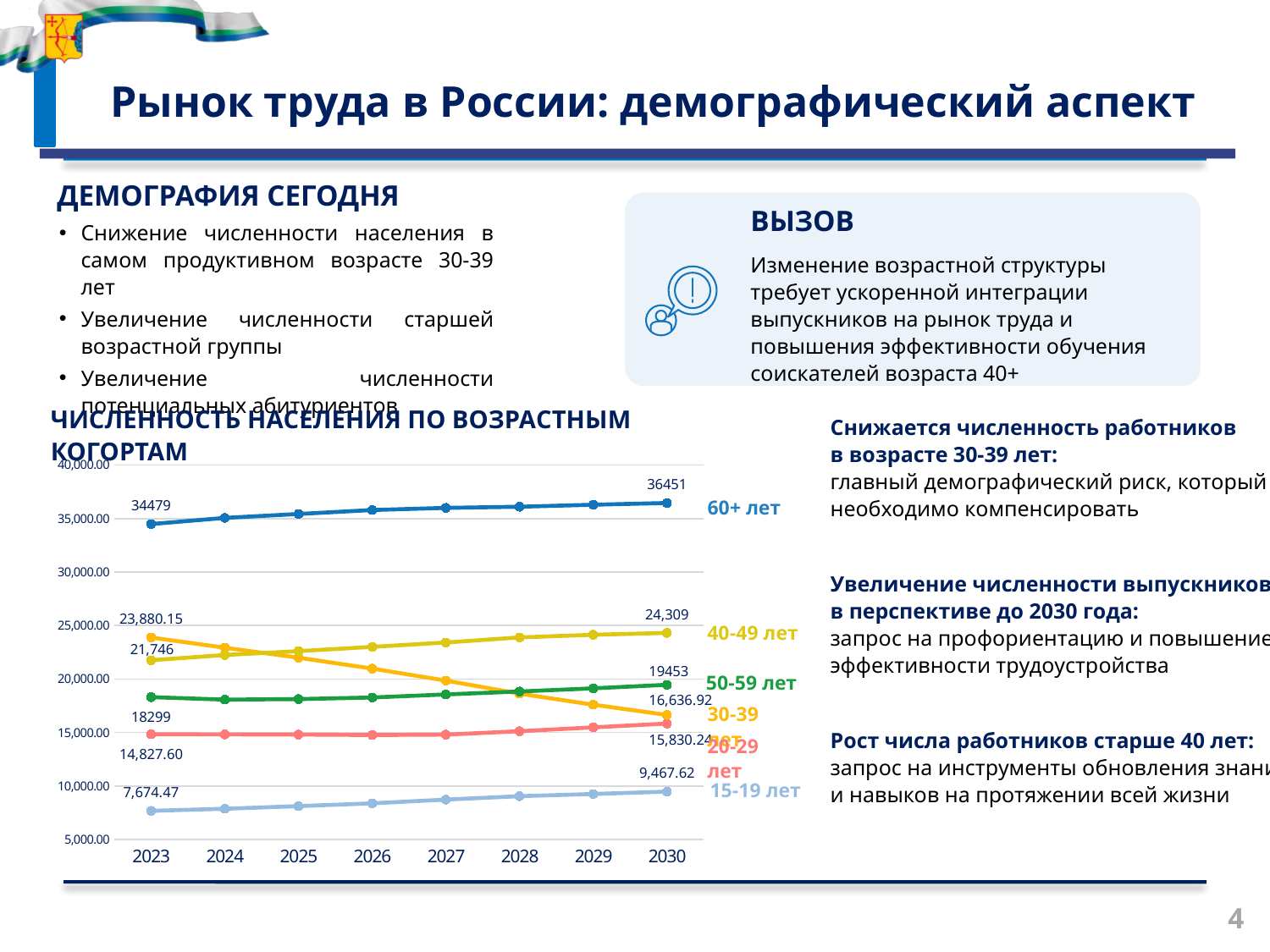
What is the value for the 60+ лет series in 2030? 36451 By how much does the 60+ лет series increase from 2023 to 2030? 1972 Does the 30-39 лет series rise or fall from 2023 to 2030? fall How many age-group series are plotted on the chart? 6 What is the value for the 60+ лет series in 2023? 34479 Which age group has the lowest value in 2030? 15-19 лет What kind of chart is shown on the slide? line chart In 2030, which is larger: the 40-49 лет value or the 50-59 лет value? 40-49 лет Which age group has the highest value in 2023? 60+ лет What is the value for the 30-39 лет series in 2023? 23,880.15 What is the value for the 30-39 лет series in 2030? 16,636.92 How many years are shown on the x axis of the chart? 8